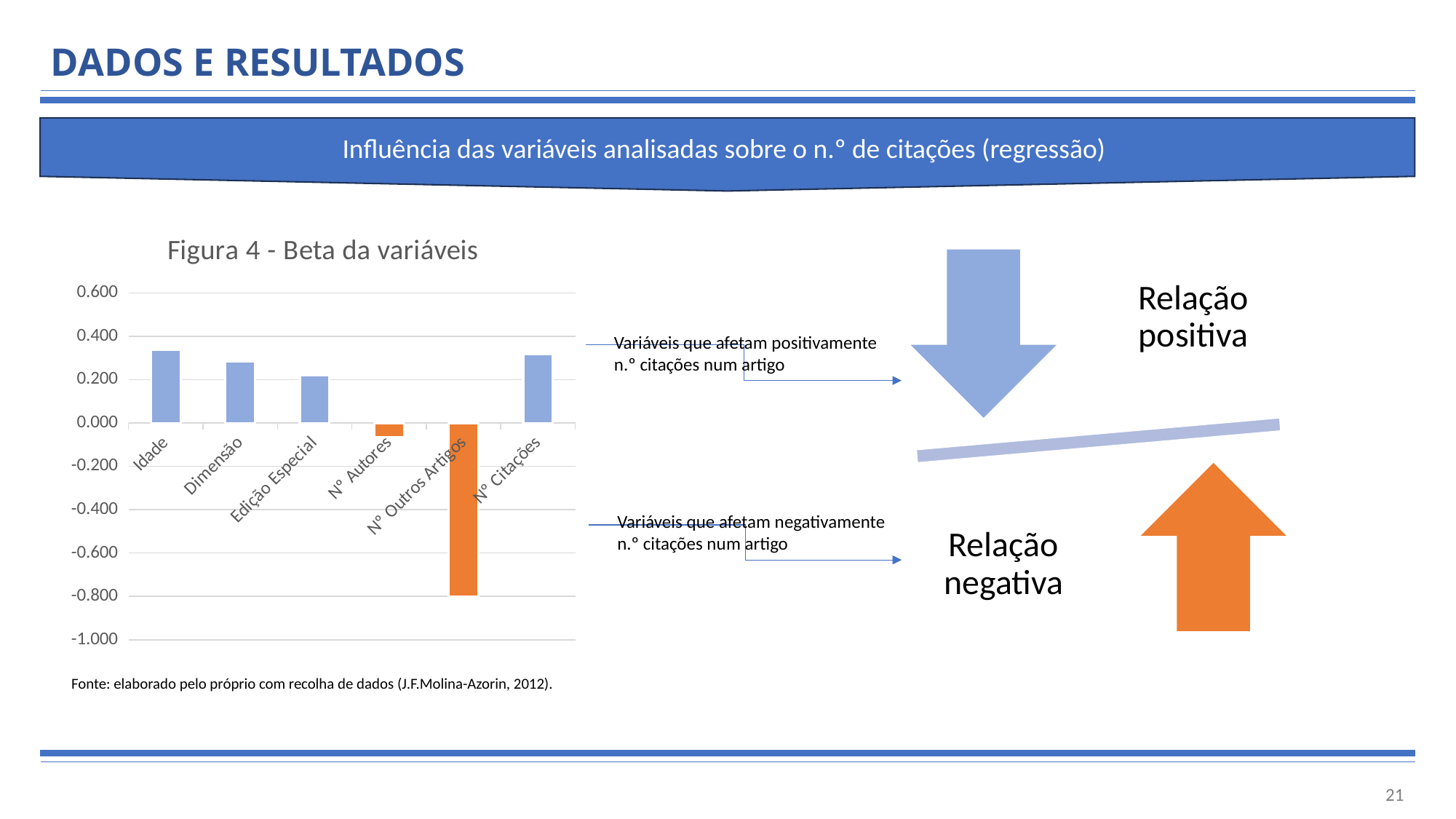
In Figura 4 - Beta da variáveis, is the value for Idade greater or less than 0.200? greater In Figura 4 - Beta da variáveis, which is larger, the value for Idade or the value for Dimensão? Idade What kind of chart is Figura 4 - Beta da variáveis? bar chart In Figura 4 - Beta da variáveis, is the value for Dimensão greater or less than 0.200? greater In Figura 4 - Beta da variáveis, is the value for Nº Outros Artigos greater or less than -0.600? less How many categories are shown in the chart Figura 4 - Beta da variáveis? 6 Which category has the lowest value in Figura 4 - Beta da variáveis? Nº Outros Artigos In Figura 4 - Beta da variáveis, which is larger, the value for Dimensão or the value for Edição Especial? Dimensão What colour are the bars with negative values in Figura 4 - Beta da variáveis? orange How many categories in Figura 4 - Beta da variáveis have a negative value? 2